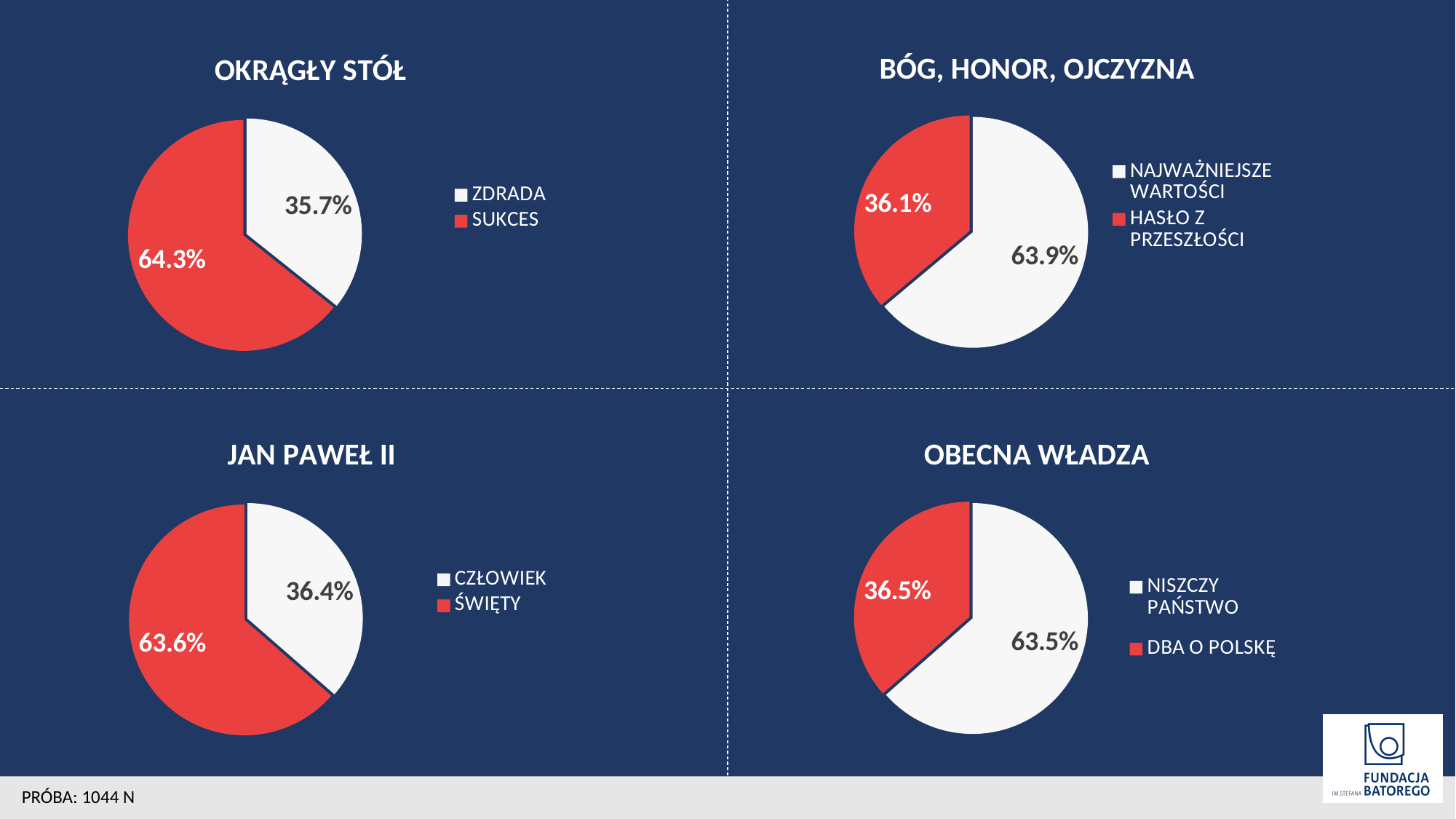
How many entries does the legend of the 'OBECNA WŁADZA' chart list? 2 In the 'OKRĄGŁY STÓŁ' chart, what share is labelled for SUKCES? 64.3% What type of chart is used in the 'BÓG, HONOR, OJCZYZNA' panel? Pie chart In the 'BÓG, HONOR, OJCZYZNA' chart, what share is labelled for HASŁO Z PRZESZŁOŚCI? 36.1% In the 'OBECNA WŁADZA' chart, what share is labelled for NISZCZY PAŃSTWO? 63.5% In the 'OKRĄGŁY STÓŁ' chart, what is the difference between the SUKCES and ZDRADA shares? 28.6% In the 'OKRĄGŁY STÓŁ' chart, what share is labelled for ZDRADA? 35.7% In the 'BÓG, HONOR, OJCZYZNA' chart, what share is labelled for NAJWAŻNIEJSZE WARTOŚCI? 63.9% In the 'OBECNA WŁADZA' chart, which slice is larger: NISZCZY PAŃSTWO or DBA O POLSKĘ? NISZCZY PAŃSTWO In the 'JAN PAWEŁ II' chart, what share is labelled for ŚWIĘTY? 63.6% In the 'JAN PAWEŁ II' chart, which slice is the largest? ŚWIĘTY How many slices does the 'JAN PAWEŁ II' pie chart have? 2